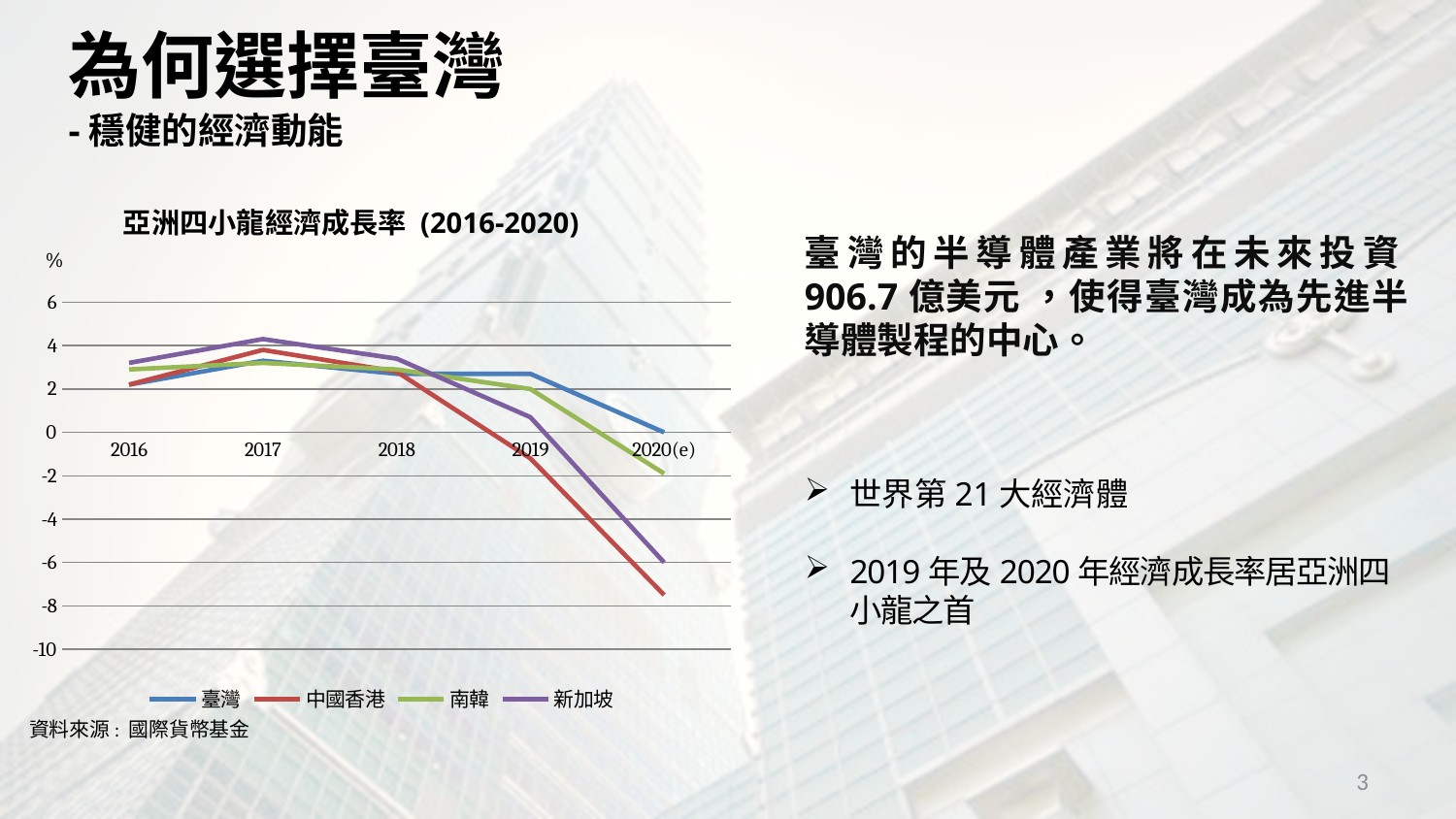
Is the value for 中國香港 in 2019 greater or less than 0? less Is the value for 中國香港 in 2020(e) greater or less than -6? less Does the value for 中國香港 rise or fall from 2017 to 2020(e)? fall What is the title of the chart? 亞洲四小龍經濟成長率 (2016-2020) How many years are plotted along the x axis of the chart? 5 Which series has the lowest value in 2020(e)? 中國香港 Is the value for 新加坡 in 2017 greater or less than 4? greater What kind of chart is shown on the slide? line chart Which series has the highest value in 2020(e)? 臺灣 In 2019, which is larger: the value for 臺灣 or the value for 新加坡? 臺灣 How many series does the legend of the chart list? 4